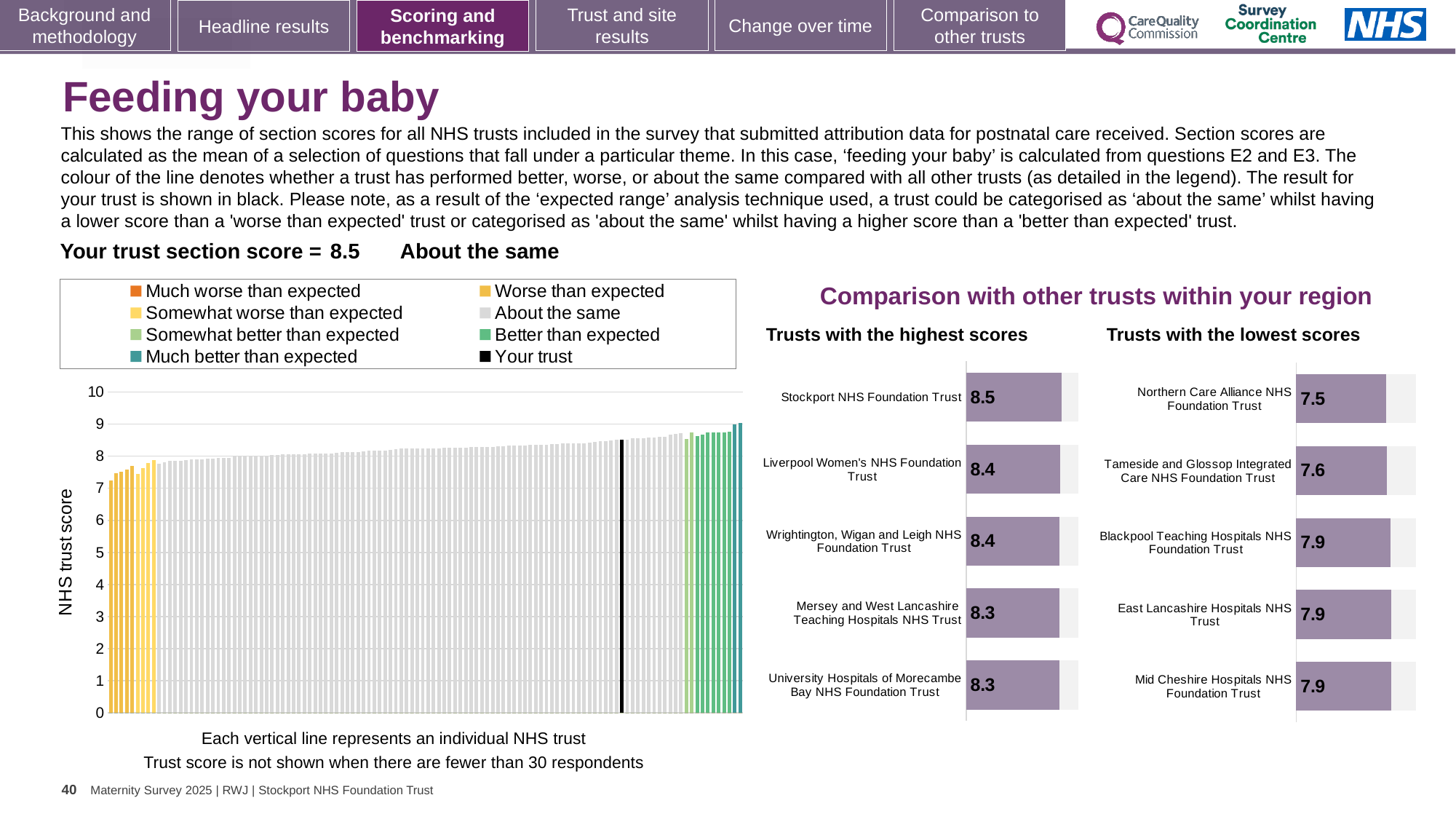
In the 'Trusts with the highest scores' chart, what is the difference between the scores of Stockport NHS Foundation Trust and University Hospitals of Morecambe Bay NHS Foundation Trust? 0.2 In the 'Trusts with the lowest scores' chart, which trust has the lowest score? Northern Care Alliance NHS Foundation Trust In the 'Trusts with the lowest scores' chart, which has the larger score: Tameside and Glossop Integrated Care NHS Foundation Trust or East Lancashire Hospitals NHS Trust? East Lancashire Hospitals NHS Trust In the 'Trusts with the lowest scores' chart, what is the score for Tameside and Glossop Integrated Care NHS Foundation Trust? 7.6 How many trusts are shown in the 'Trusts with the highest scores' chart? 5 In the NHS trust score chart on the left, is the value for the black bar representing your trust greater or less than 8? greater What kind of chart is the NHS trust score chart on the left? Bar chart In the 'Trusts with the lowest scores' chart, what is the difference between the scores of Blackpool Teaching Hospitals NHS Foundation Trust and Northern Care Alliance NHS Foundation Trust? 0.4 In the 'Trusts with the highest scores' chart, which trust has the highest score? Stockport NHS Foundation Trust In the 'Trusts with the highest scores' chart, what is the score for Mersey and West Lancashire Teaching Hospitals NHS Trust? 8.3 In the 'Trusts with the highest scores' chart, what is the score for Stockport NHS Foundation Trust? 8.5 In the 'Trusts with the lowest scores' chart, what is the score for Northern Care Alliance NHS Foundation Trust? 7.5